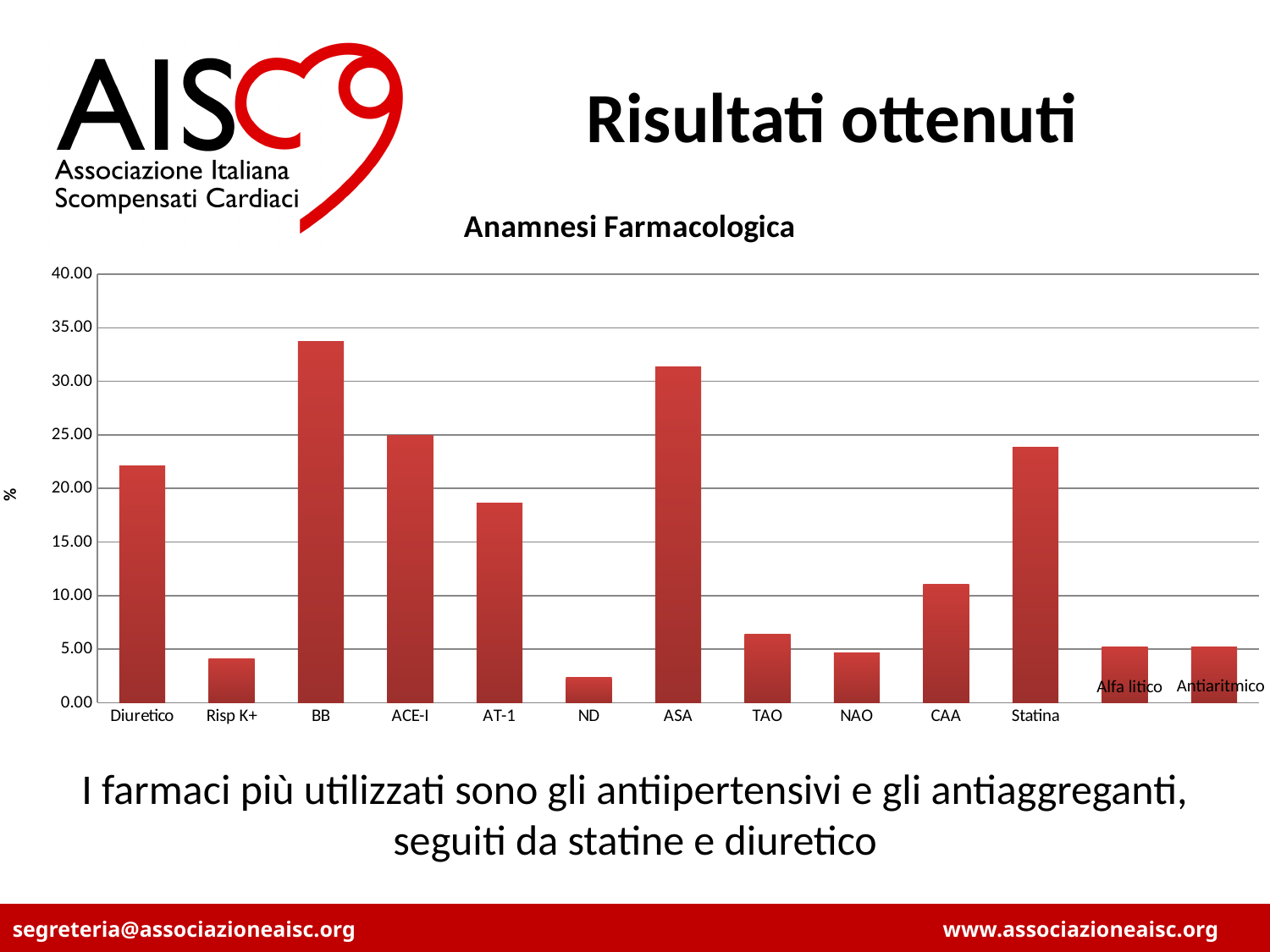
Which has a larger value, ASA or Statina? ASA Which category has the lowest value in the chart? ND How many categories are shown on the x axis of the chart? 13 Is the value for Statina greater or less than 25.00? less Which has a larger value, ACE-I or AT-1? ACE-I Is the value for BB greater or less than 30.00? greater Which category has the highest value in the chart? BB What is the label on the vertical axis of the chart? % What kind of chart is shown on the slide? bar chart Is the value for Diuretico greater or less than 20.00? greater What is the title of the chart? Anamnesi Farmacologica